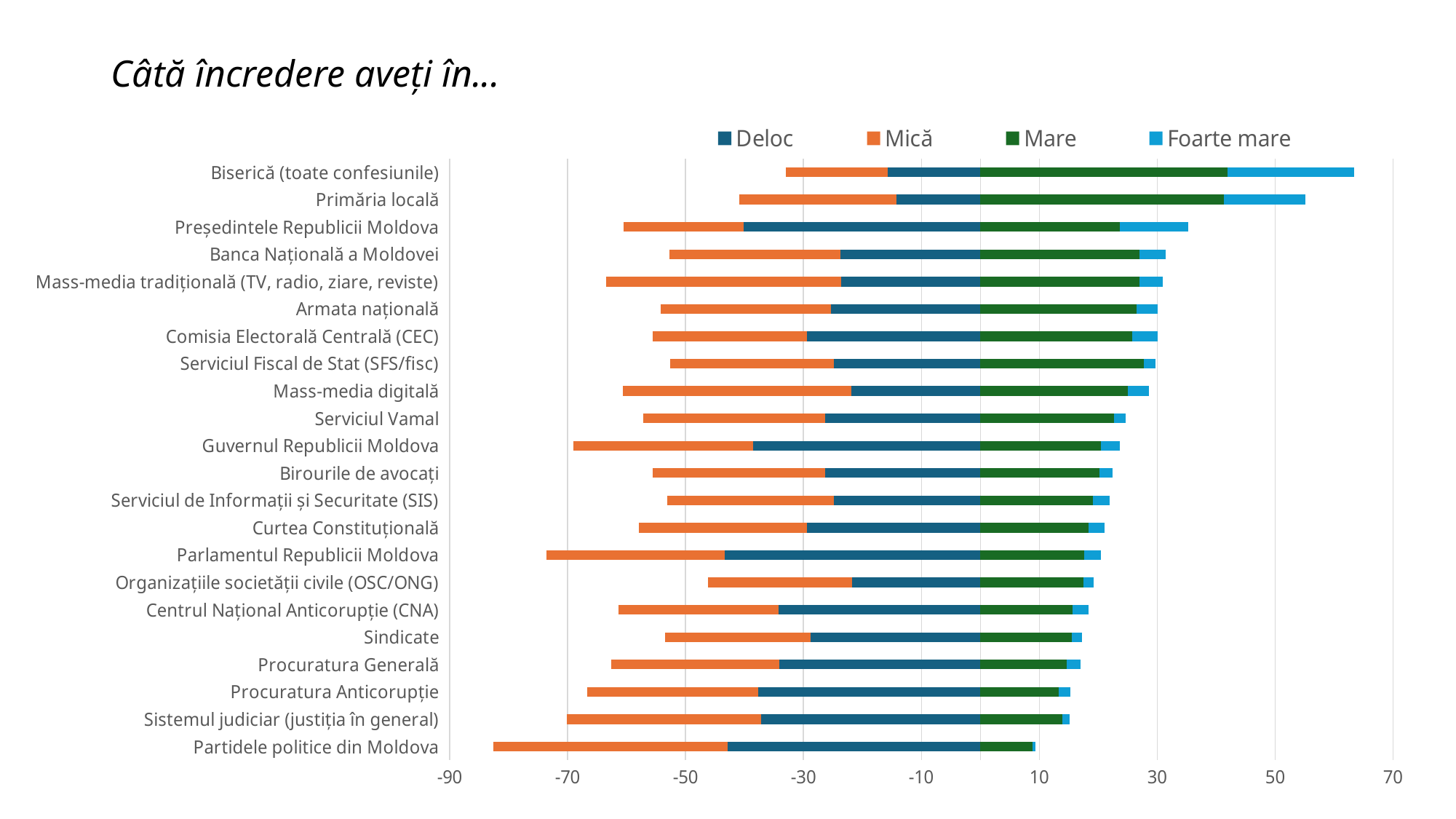
What kind of chart is shown on the slide? bar chart Which legend entry is shown in orange? Mică How many series does the chart legend list? 4 What is the title of the chart? Câtă încredere aveți în... Which category's bar extends furthest to the left (negative side) of the axis? Partidele politice din Moldova Is the left end of the bar for Partidele politice din Moldova greater or less than -70? less Which category's bar extends furthest to the right (positive side) of the axis? Biserică (toate confesiunile) Whose bar extends further to the right: Biserică (toate confesiunile) or Primăria locală? Biserică (toate confesiunile) Is the right end of the bar for Biserică (toate confesiunile) greater or less than 50? greater How many categories (institutions) are listed on the vertical axis of the chart? 22 Is the right end of the bar for Președintele Republicii Moldova greater or less than 30? greater